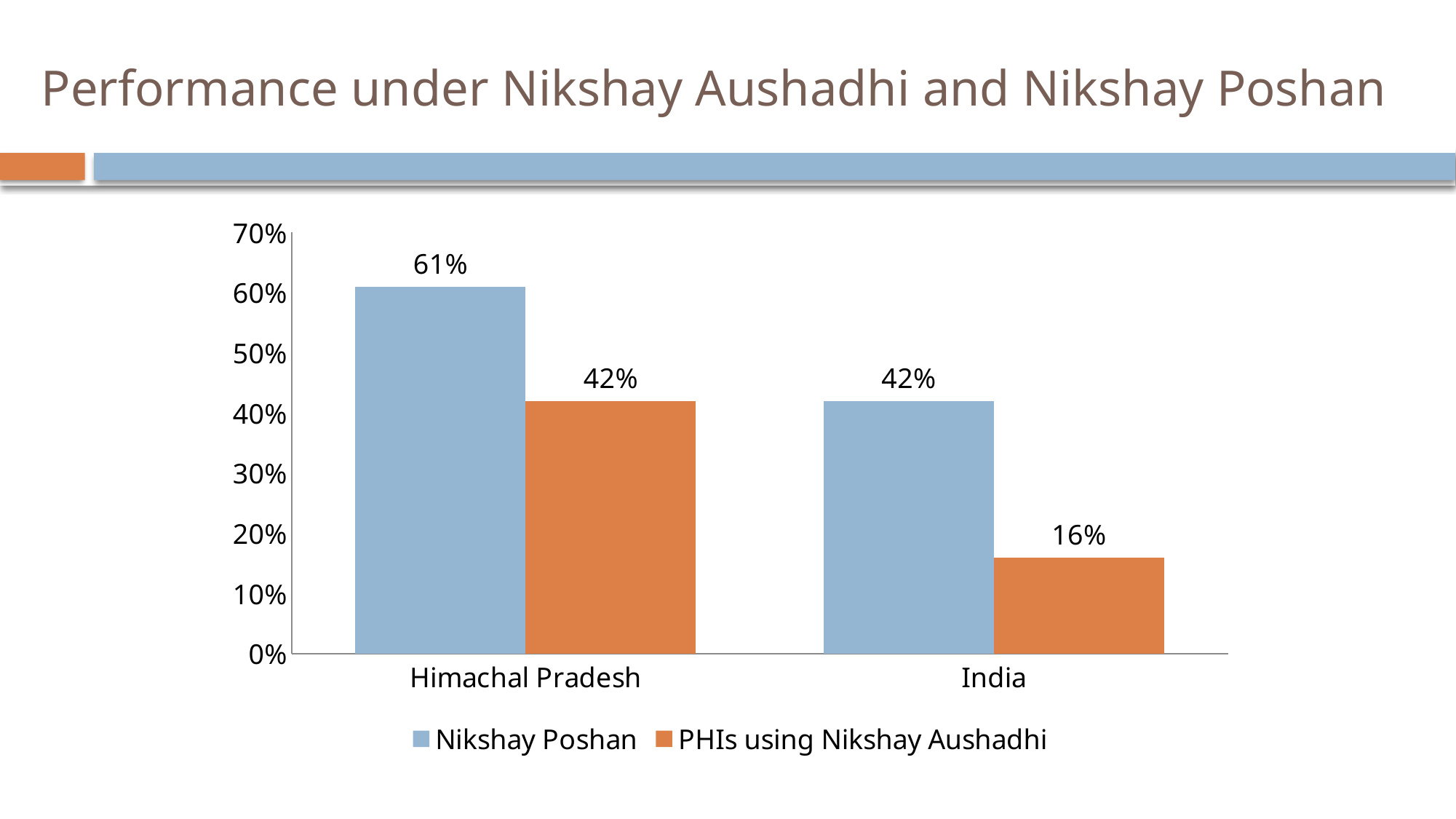
What is the PHIs using Nikshay Aushadhi value for India? 16% What is the Nikshay Poshan value for Himachal Pradesh? 61% What is the difference between the Nikshay Poshan values for Himachal Pradesh and India? 19% Which category has the lowest PHIs using Nikshay Aushadhi value? India How many categories are shown on the x axis? 2 What kind of chart is shown on the slide? Bar chart Which category has the highest Nikshay Poshan value? Himachal Pradesh Which is larger: the Nikshay Poshan value for Himachal Pradesh or the Nikshay Poshan value for India? Himachal Pradesh How many series does the legend list? 2 What is the PHIs using Nikshay Aushadhi value for Himachal Pradesh? 42% What is the difference between the PHIs using Nikshay Aushadhi values for Himachal Pradesh and India? 26% What is the Nikshay Poshan value for India? 42%